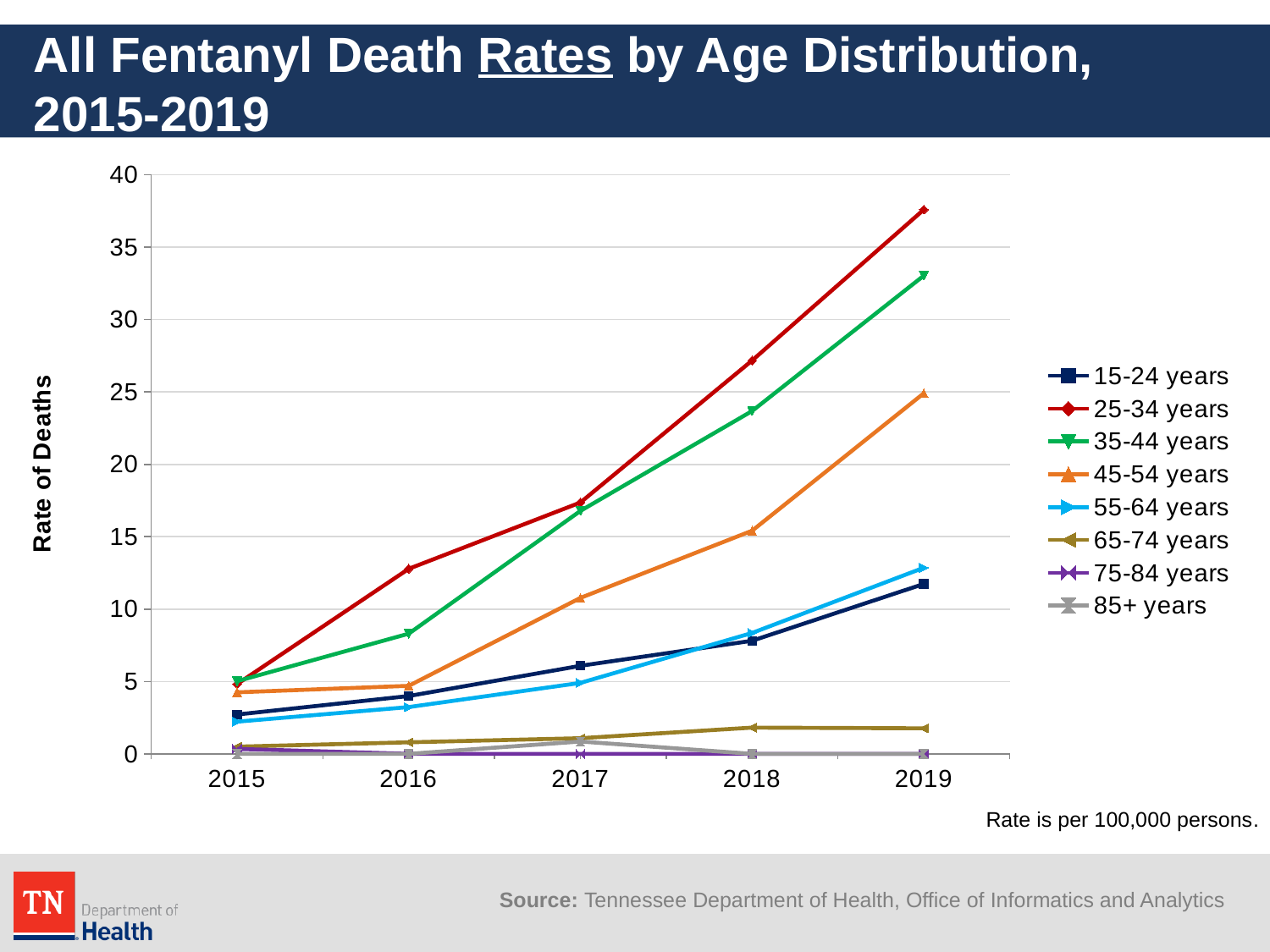
What kind of chart is shown on the slide? line chart Is the value for 35-44 years in 2019 greater or less than 30? greater How many series does the legend list? 8 In 2019, which is larger: the rate for 25-34 years or the rate for 45-54 years? 25-34 years How many years are plotted along the x axis? 5 Does the rate for 25-34 years rise or fall from 2015 to 2019? rise Is the value for 45-54 years in 2018 greater or less than 20? less Which age group has the highest fentanyl death rate in 2018? 25-34 years What is the title of the y axis? Rate of Deaths Which age group has the highest fentanyl death rate in 2019? 25-34 years Is the value for 65-74 years in 2019 greater or less than 5? less